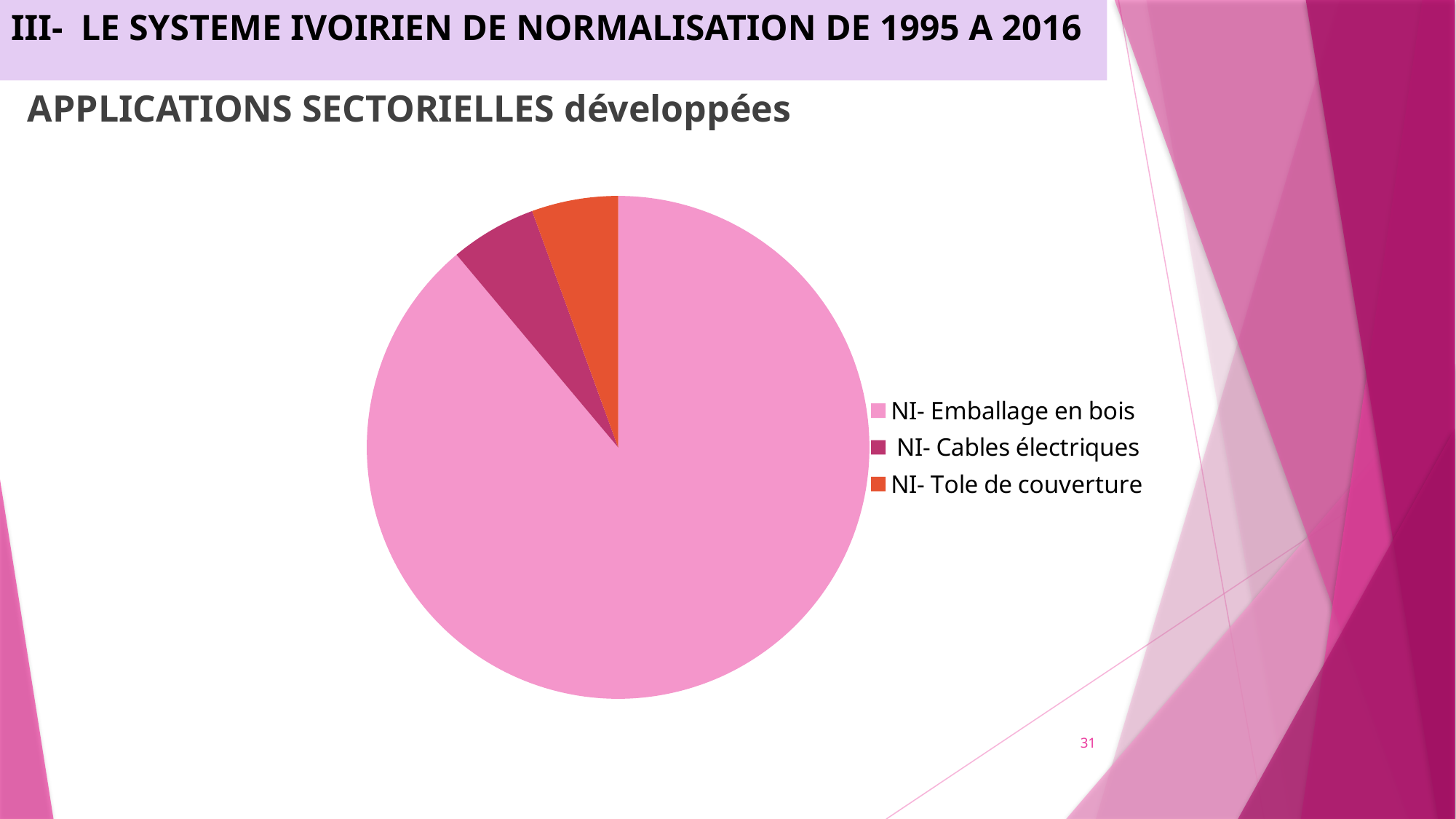
Which category is shown in orange in the pie chart? NI- Tole de couverture How many entries does the legend of the pie chart list? 3 What is the heading written above the pie chart? APPLICATIONS SECTORIELLES développées What kind of chart is shown on the slide? pie chart How many slices does the pie chart have? 3 Which slice is larger, NI- Emballage en bois or NI- Cables électriques? NI- Emballage en bois Which slice is larger, NI- Emballage en bois or NI- Tole de couverture? NI- Emballage en bois Which category has the largest slice in the pie chart? NI- Emballage en bois